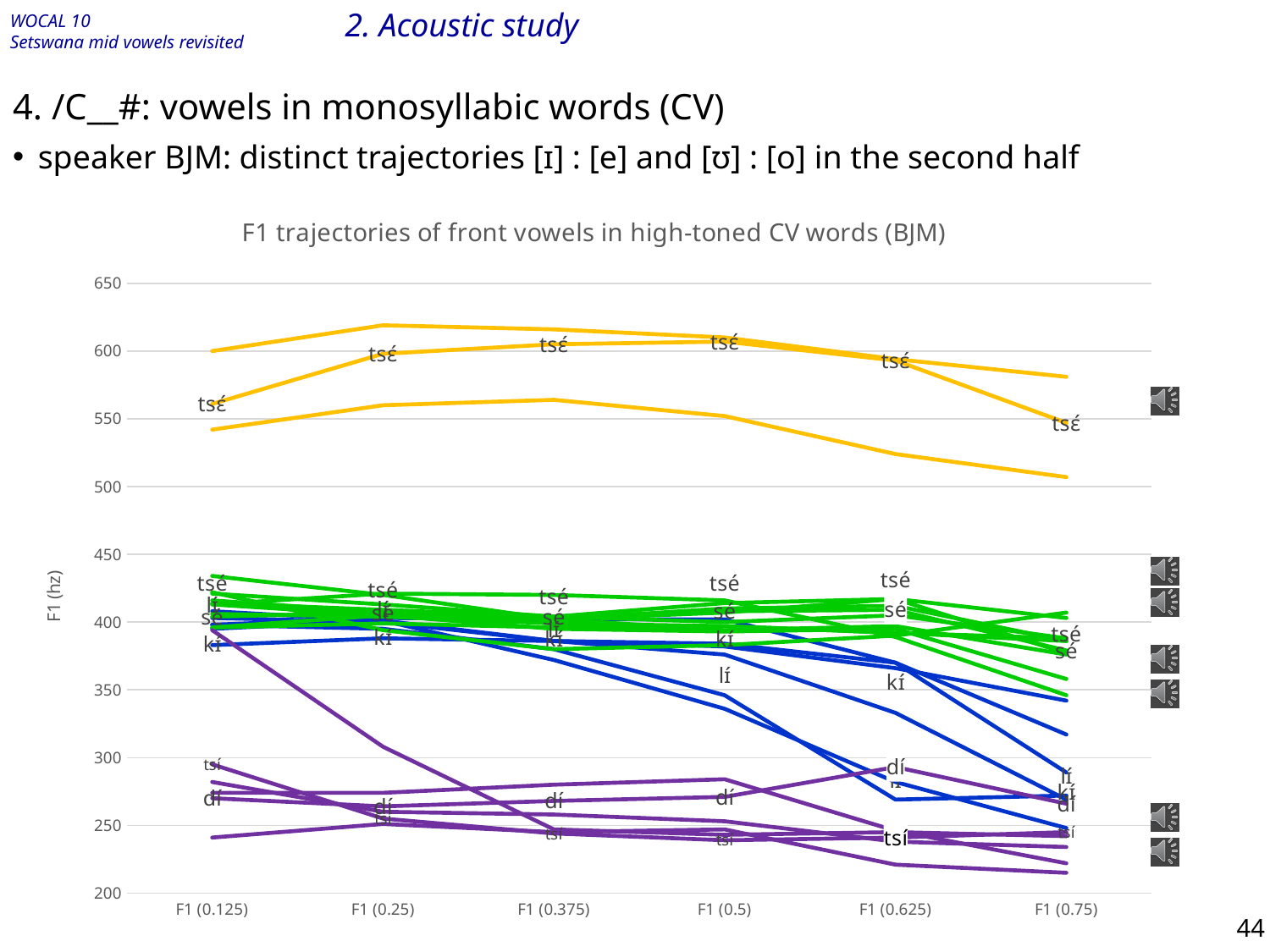
Are the F1 values of the tsɛ́ trajectories at F1 (0.75) greater or less than 500? greater Do the kí and lí trajectories rise or fall between F1 (0.5) and F1 (0.75)? fall What kind of chart is shown on the slide? line chart Is the F1 value of the tsé trajectories at F1 (0.125) greater or less than 350? greater How many time points are shown along the x axis of the chart? 6 Do the tsɛ́ trajectories rise or fall between F1 (0.625) and F1 (0.75)? fall What is the highest value shown on the vertical axis of the chart? 650 What is the title of the chart? F1 trajectories of front vowels in high-toned CV words (BJM) Are the F1 values of the tsí trajectories at F1 (0.75) greater or less than 300? less At F1 (0.125), which has the higher F1 value: tsɛ́ or dí? tsɛ́ Which word's trajectories have the highest F1 values in the chart? tsɛ́ What is the label on the vertical axis of the chart? F1 (hz)